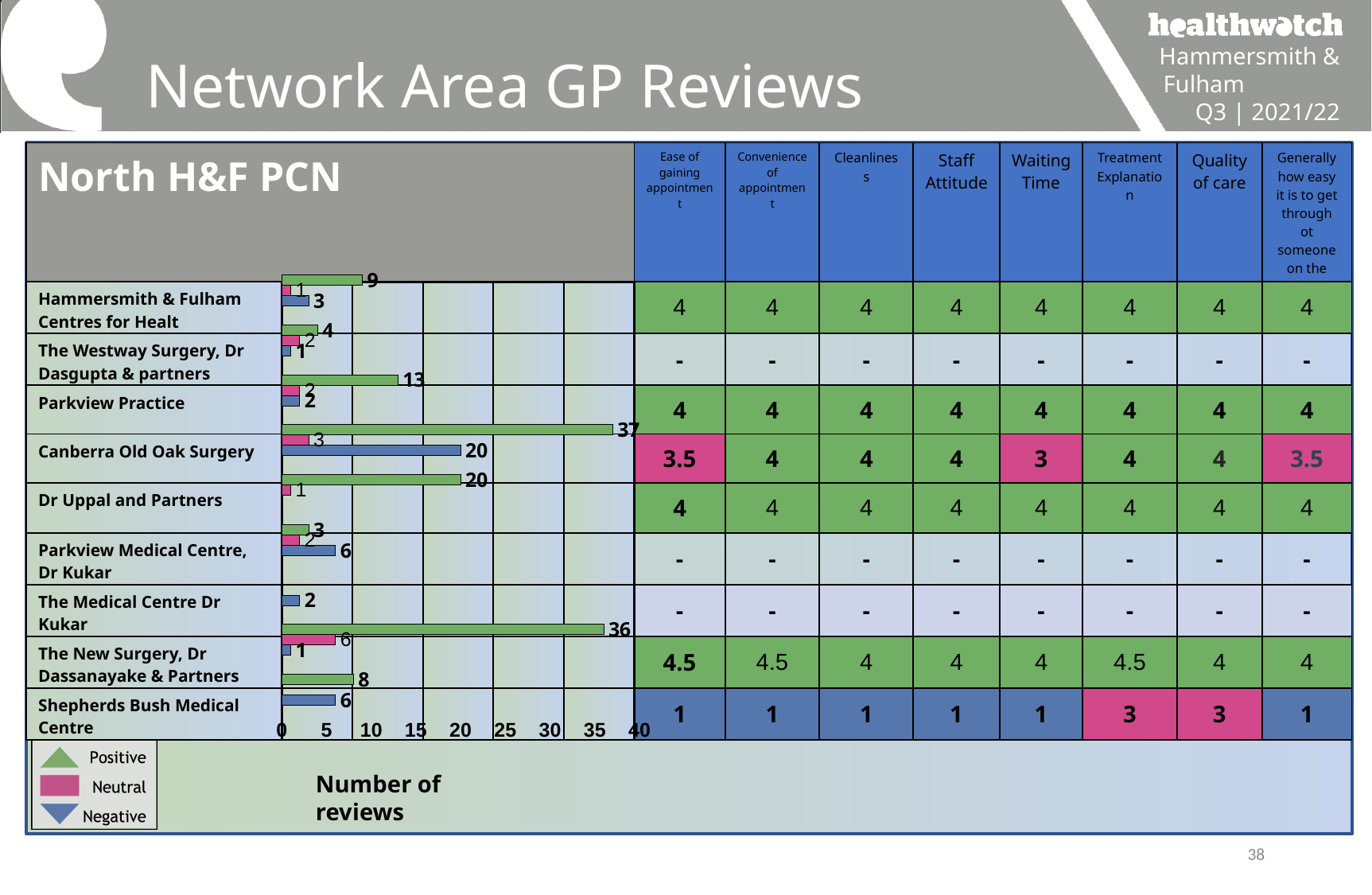
What are the three series named in the chart legend? Positive, Neutral, Negative What is the difference between the positive reviews for Canberra Old Oak Surgery and The New Surgery, Dr Dassanayake & Partners? 1 What is the highest value shown on the x axis of the chart? 40 What is the number of positive reviews for The New Surgery, Dr Dassanayake & Partners? 36 What is the number of positive reviews for Canberra Old Oak Surgery? 37 What kind of chart is shown on the slide? bar chart What is the number of negative reviews for Canberra Old Oak Surgery? 20 How many series does the chart legend list? 3 What is the number of positive reviews for Shepherds Bush Medical Centre? 8 Is the number of positive reviews for Parkview Practice greater or less than 15? less What is the number of positive reviews for Parkview Practice? 13 Which practice has the highest number of positive reviews? Canberra Old Oak Surgery